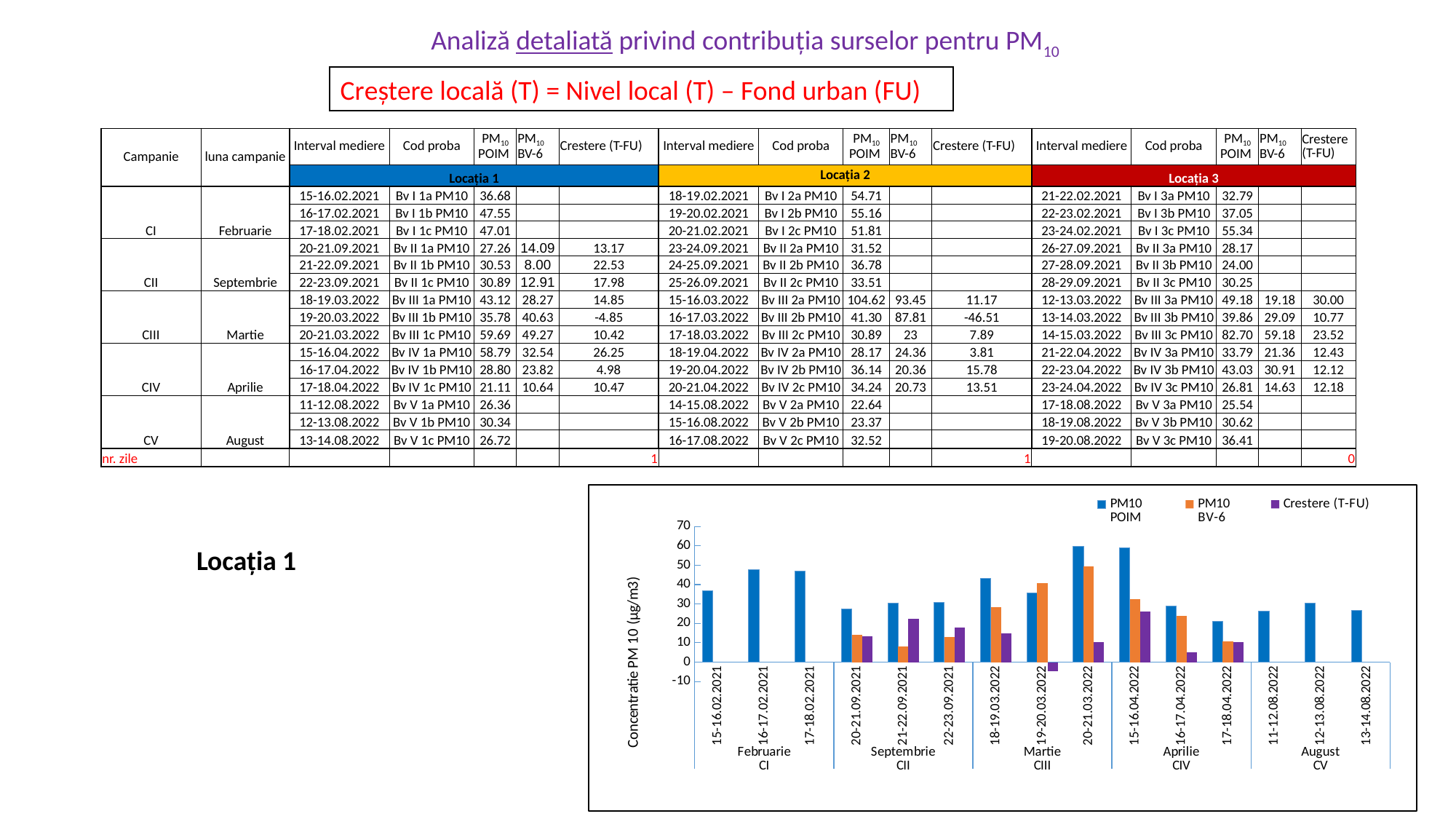
For 19-20.03.2022, which is larger: PM10 POIM or PM10 BV-6? PM10 BV-6 Is the PM10 BV-6 value for 20-21.03.2022 greater or less than 40? greater Which date has a negative Crestere (T-FU) value in the chart? 19-20.03.2022 Is the PM10 POIM value for 16-17.02.2021 greater or less than 40? greater How many series does the chart legend list? 3 Is the PM10 BV-6 value for 21-22.09.2021 greater or less than 10? less How many date categories are plotted along the x axis of the chart? 15 What is the y-axis label of the chart? Concentratie PM 10 (µg/m3) Which location does the chart refer to? Locația 1 Which is larger: the PM10 POIM value for 15-16.02.2021 or for 16-17.02.2021? 16-17.02.2021 Which date has the lowest PM10 POIM value in the chart? 17-18.04.2022 What kind of chart is shown on the slide? bar chart